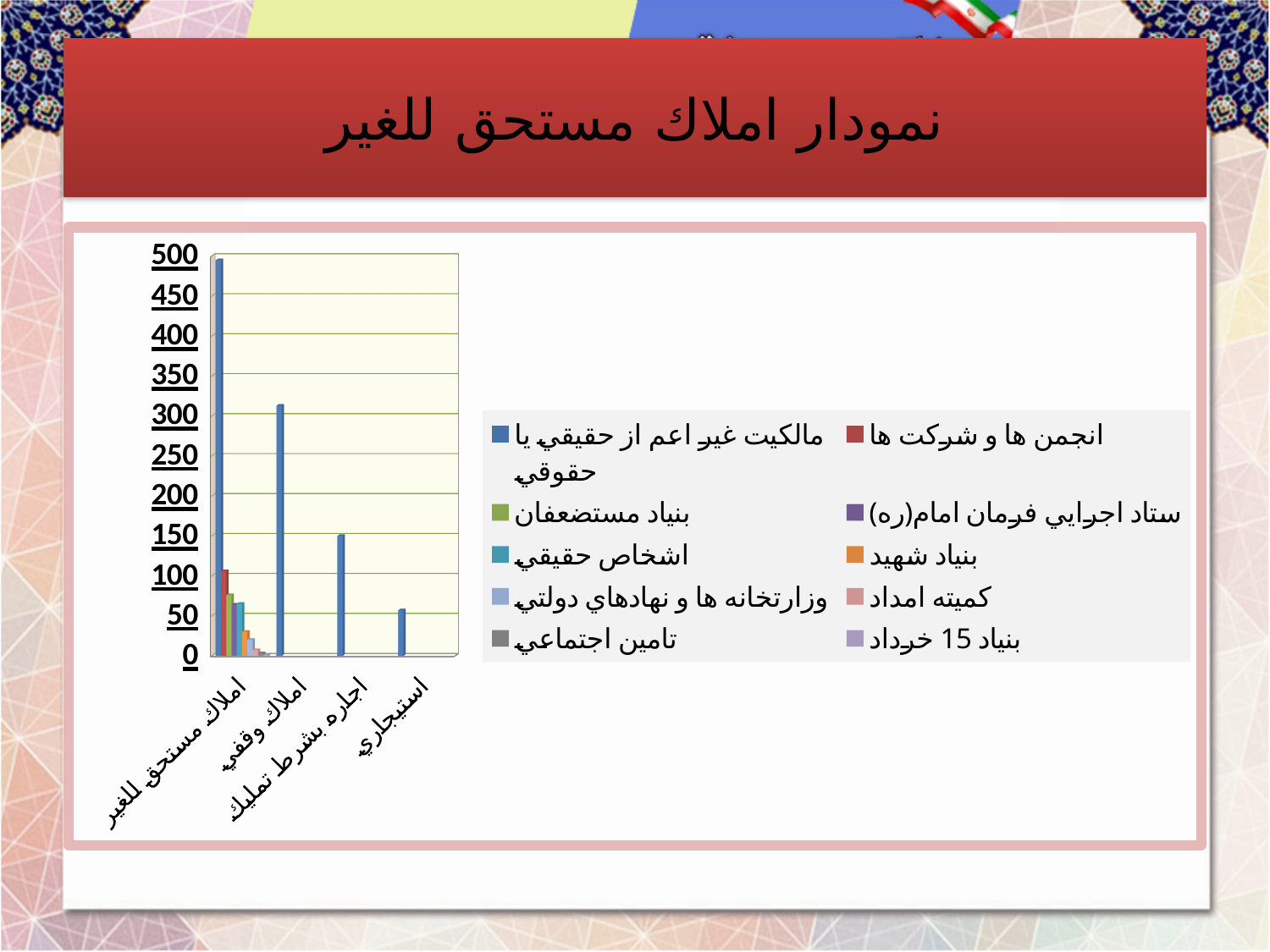
Is the value of مالكيت غير اعم از حقيقي يا حقوقي for املاك وقفي greater or less than 250? greater For the series مالكيت غير اعم از حقيقي يا حقوقي, which is larger: املاك وقفي or اجاره بشرط تمليك? املاك وقفي What kind of chart is shown on the slide? bar chart What is the title of the slide's chart? نمودار املاك مستحق للغير Is the value of مالكيت غير اعم از حقيقي يا حقوقي for اجاره بشرط تمليك greater or less than 200? less How many series does the chart's legend list? 10 Is the value of مالكيت غير اعم از حقيقي يا حقوقي for املاك مستحق للغير greater or less than 450? greater Which category has the highest value for the series مالكيت غير اعم از حقيقي يا حقوقي? املاك مستحق للغير Do the values of the series مالكيت غير اعم از حقيقي يا حقوقي rise or fall from left to right along the x axis? fall Which category has the lowest value for the series مالكيت غير اعم از حقيقي يا حقوقي? استيجاري How many categories are shown on the x axis of the chart? 4